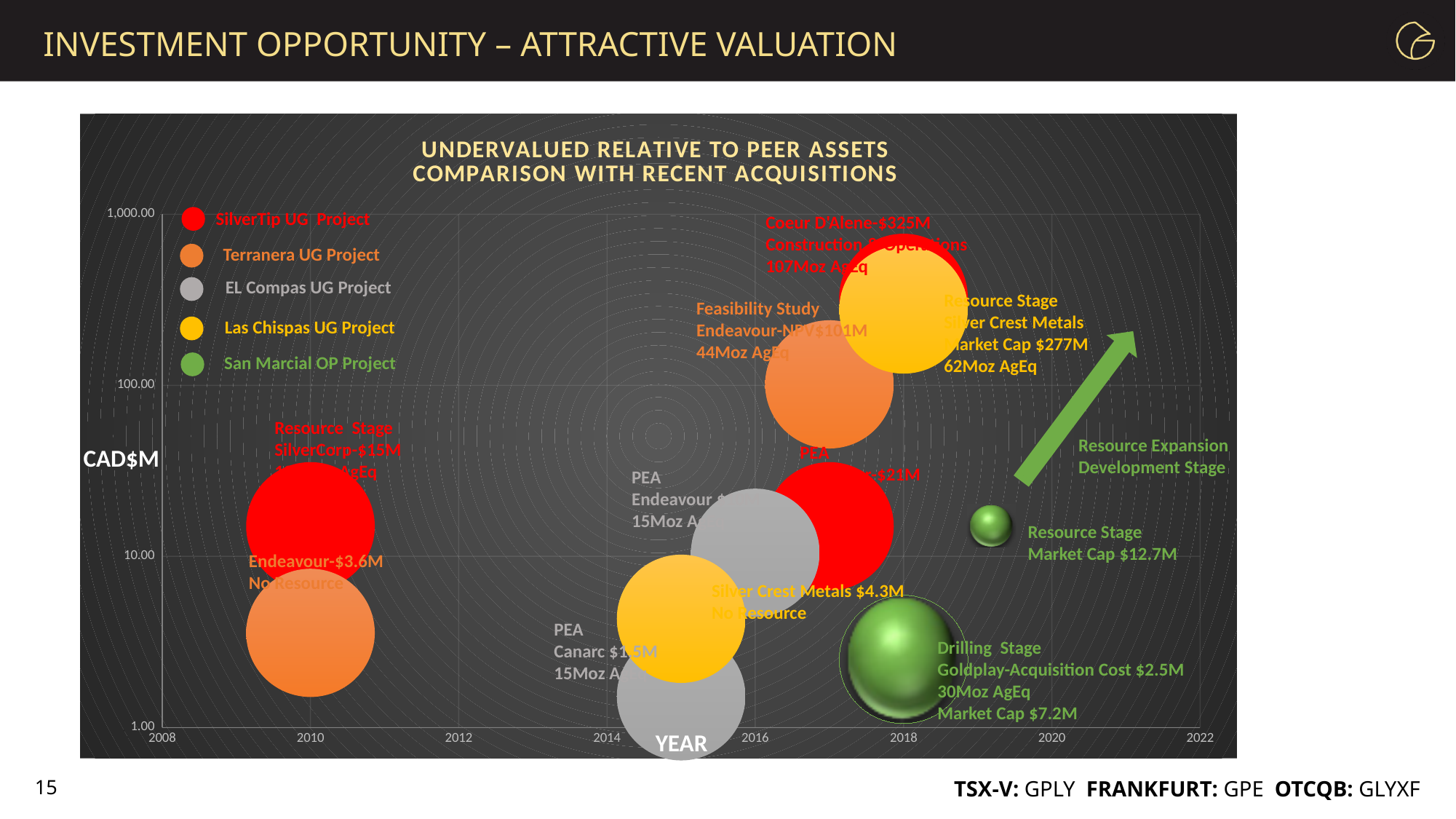
What kind of chart is shown on the slide? Bubble chart What is the difference between the Coeur D'Alene value ($325M) and the Silver Crest Metals market cap ($277M)? $48M What acquisition value is labelled for Coeur D'Alene on the chart? $325M Is the value of the large green Goldplay bubble near 2018 greater or less than 10.00 CAD$M? less How many projects does the chart legend list? 5 What acquisition cost is labelled for Goldplay at the Drilling Stage? $2.5M What market cap is labelled for Goldplay at the Drilling Stage? $7.2M What market cap is labelled for Silver Crest Metals at the Resource Stage? $277M Which is larger, the Coeur D'Alene value of $325M or the Silver Crest Metals market cap of $277M? Coeur D'Alene $325M Which colour represents the Las Chispas UG Project in the legend? Yellow What value is labelled for Canarc at the PEA stage? $1.5M What is the title of the chart? UNDERVALUED RELATIVE TO PEER ASSETS COMPARISON WITH RECENT ACQUISITIONS